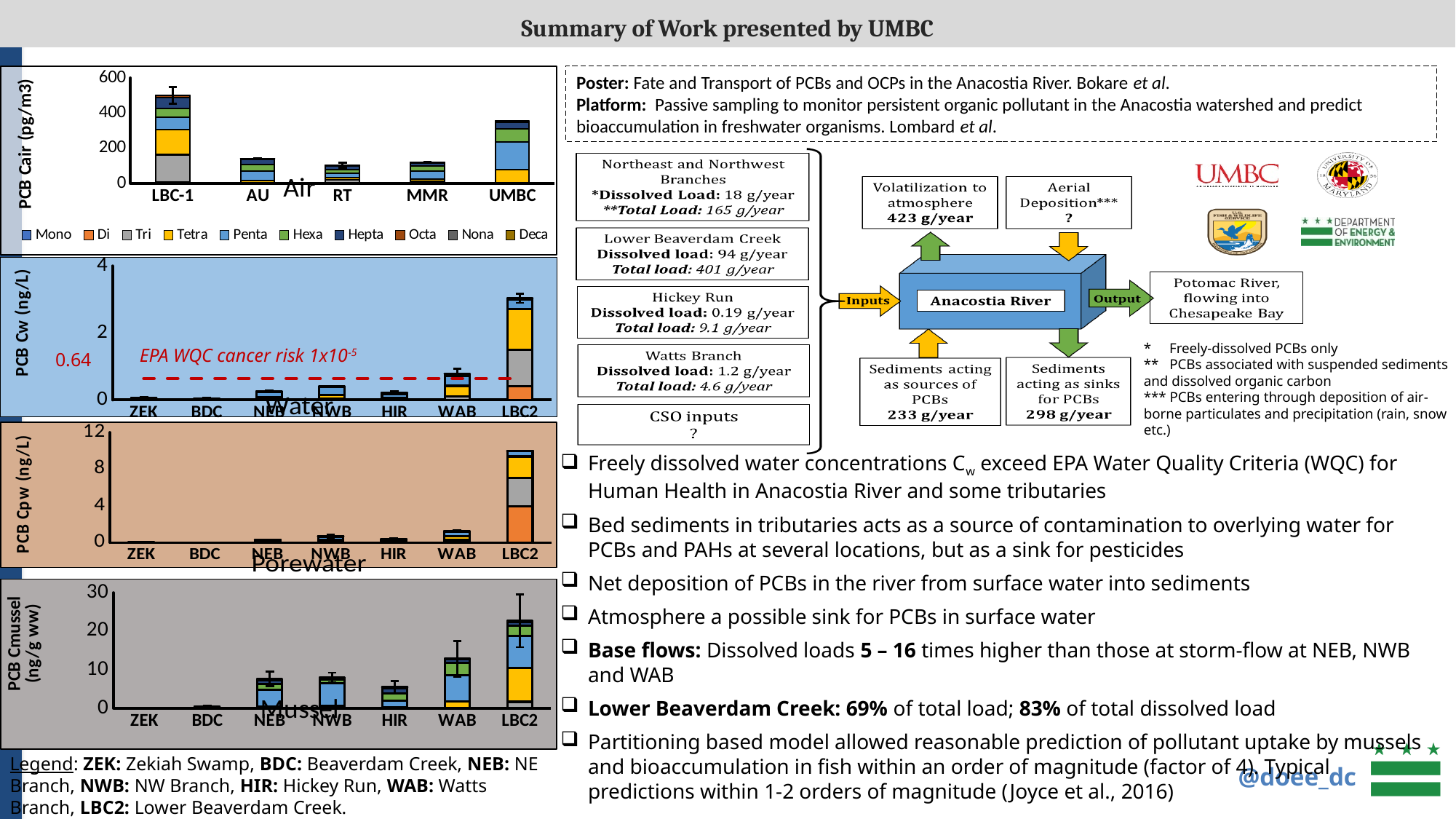
How many categories are shown on the x axis of the Water chart (PCB Cw)? 7 In the Porewater chart (PCB Cpw), is the total value for LBC2 greater or less than 8? greater What kind of chart is the Air chart (PCB Cair) at the top left of the slide? Stacked bar chart In the Water chart (PCB Cw), is the total value for LBC2 greater or less than 2? greater In the Air chart (PCB Cair), is the total value for AU greater or less than 200? less In the Mussel chart (PCB Cmussel), which has the larger total bar, WAB or NWB? WAB In the Air chart (PCB Cair), which category has the highest total bar? LBC-1 How many series does the legend below the Air chart list? 10 How many categories are shown on the x axis of the Air chart (PCB Cair)? 5 What value is marked by the red dashed EPA WQC cancer risk line in the Water chart (PCB Cw)? 0.64 In the Water chart (PCB Cw), which category has the highest total bar? LBC2